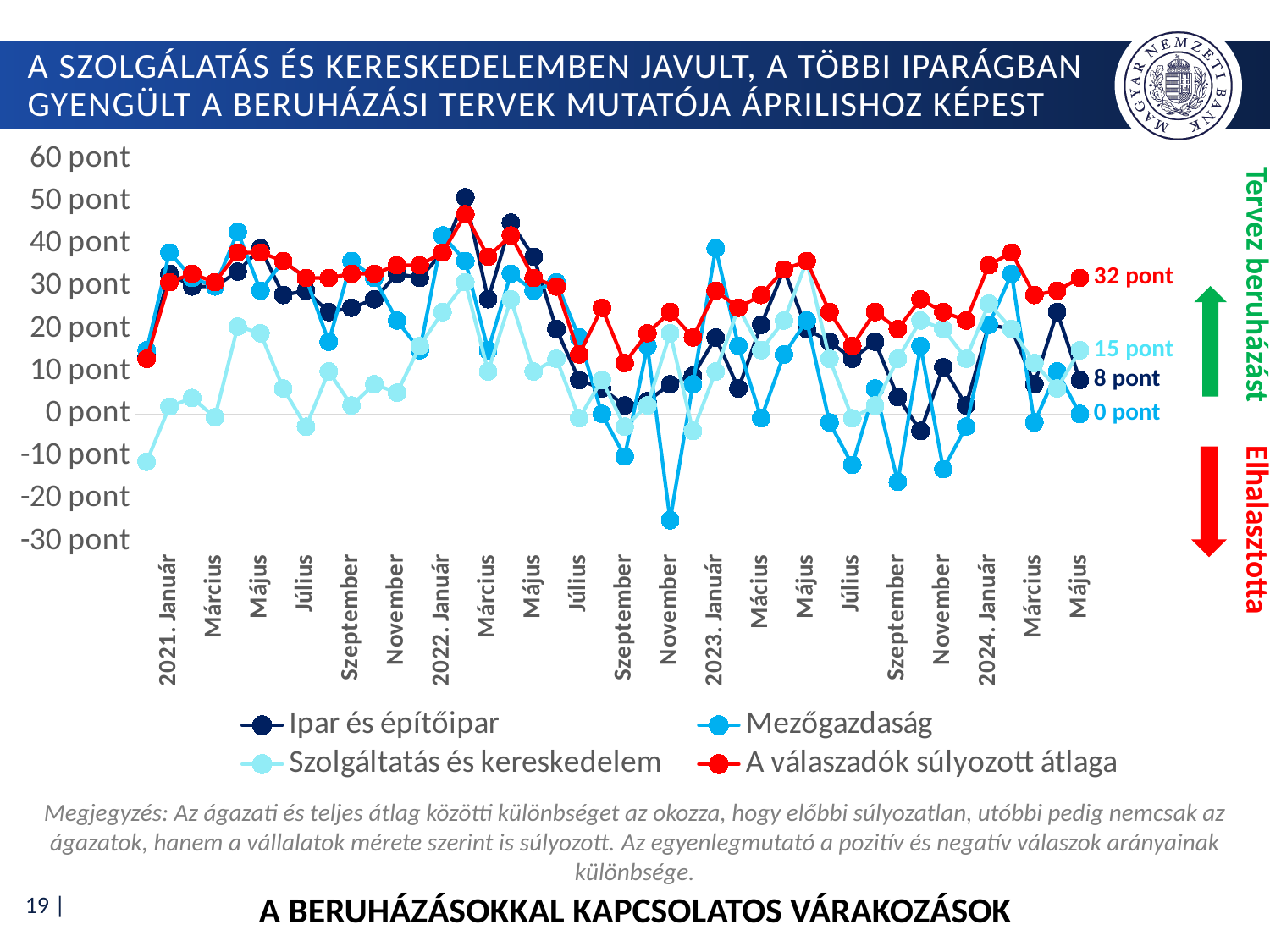
What is the value of Szolgáltatás és kereskedelem at the last point (2024 Május)? 15 pont At the last point (2024 Május), which series has the highest value? A válaszadók súlyozott átlaga How many series does the legend list? 4 Is the value for Mezőgazdaság in 2022 November greater or less than -20 pont? less At the last point (2024 Május), which is larger: Ipar és építőipar or Mezőgazdaság? Ipar és építőipar What is the value of Mezőgazdaság at the last point (2024 Május)? 0 pont What is the value of Ipar és építőipar at the last point (2024 Május)? 8 pont What is the value of A válaszadók súlyozott átlaga at the last point (2024 Május)? 32 pont What colour is the line for A válaszadók súlyozott átlaga? red At the last point (2024 Május), which series has the lowest value? Mezőgazdaság What is the difference between A válaszadók súlyozott átlaga and Szolgáltatás és kereskedelem at the last point (2024 Május)? 17 pont What kind of chart is shown on the slide? line chart